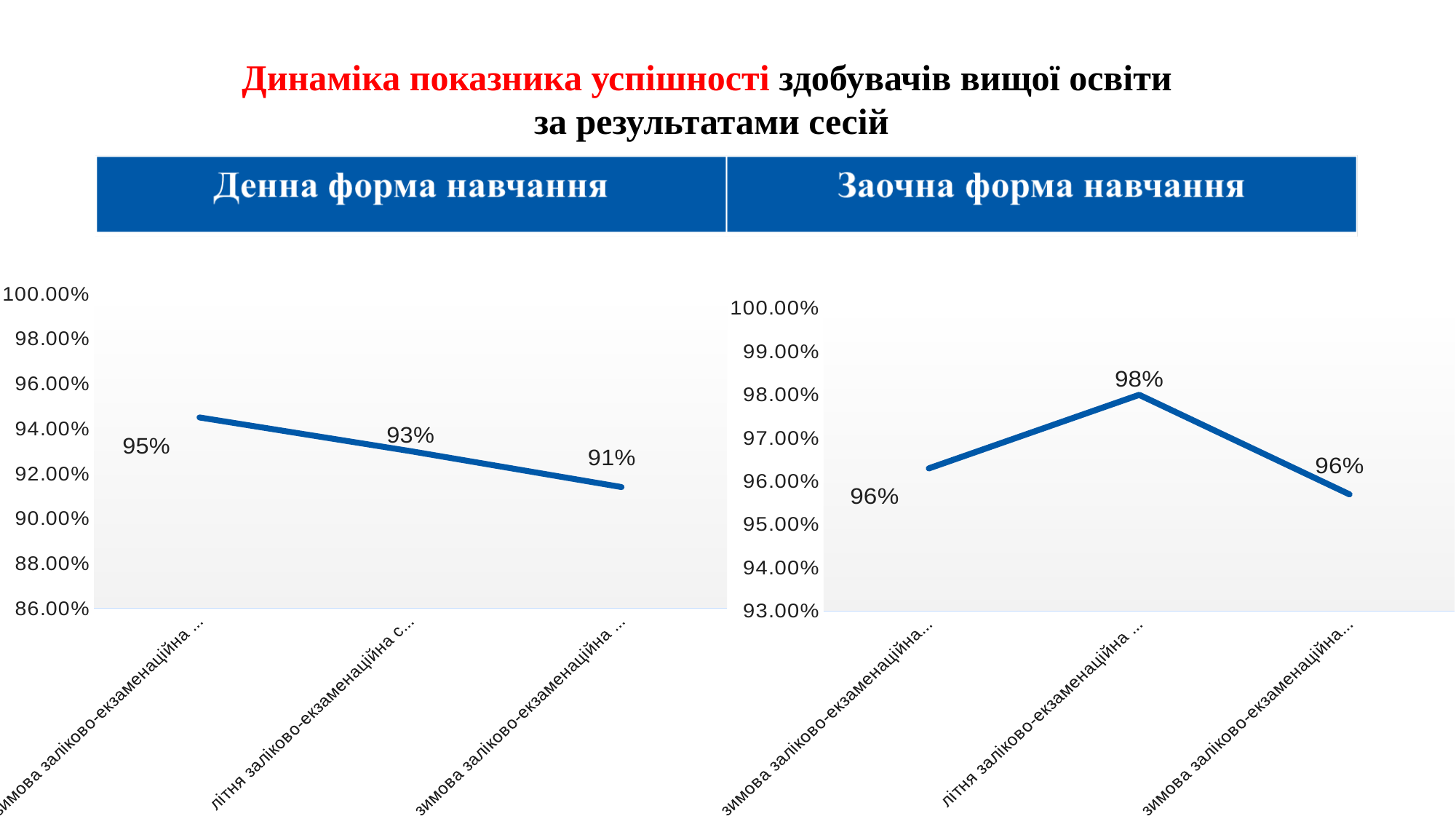
On the right chart (Заочна форма навчання), what is the difference between the middle point (98%) and the last point (96%)? 2% What kind of chart is the right chart (Заочна форма навчання)? line chart How many data points are plotted on the left chart (Денна форма навчання)? 3 On the left chart (Денна форма навчання), do the values rise or fall from left to right? fall On the left chart (Денна форма навчання), what is the difference between the first point (95%) and the last point (91%)? 4% On the left chart (Денна форма навчання), what is the value for the first point? 95% On the right chart (Заочна форма навчання), what is the value for the літня заліково-екзаменаційна session (middle point)? 98% Which is larger: the middle point on the left chart (Денна форма навчання) or the middle point on the right chart (Заочна форма навчання)? the right chart (Заочна форма навчання), 98% On the left chart (Денна форма навчання), what is the value for the літня заліково-екзаменаційна session (middle point)? 93% On the right chart (Заочна форма навчання), which point has the highest value? літня заліково-екзаменаційна (middle point) On the right chart (Заочна форма навчання), what is the value for the last point? 96% On the left chart (Денна форма навчання), what is the value for the last point? 91%